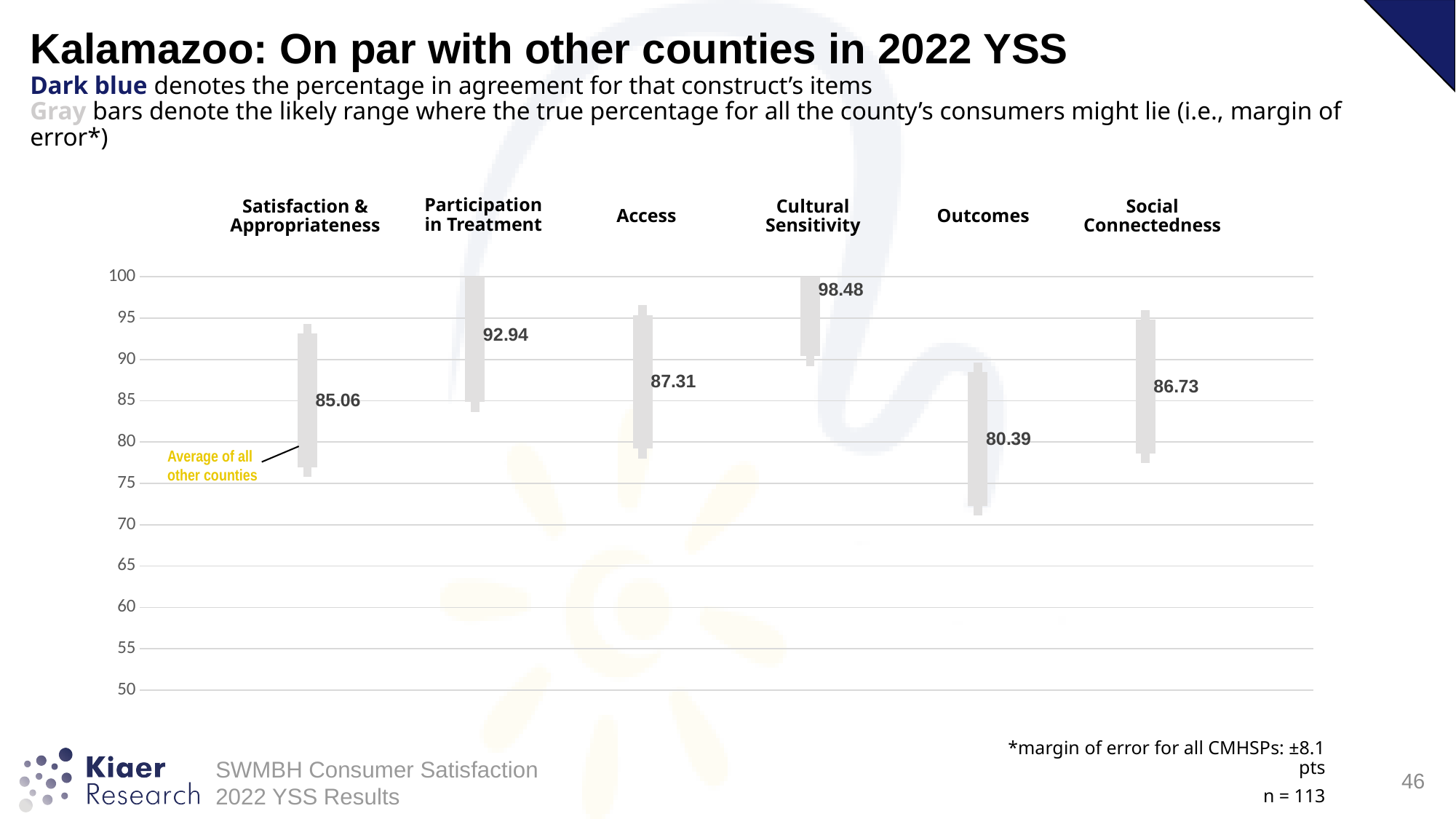
What is the value shown for Social Connectedness? 86.73 What is the difference between the values for Cultural Sensitivity and Outcomes? 18.09 What is the value shown for Cultural Sensitivity? 98.48 Which construct has the lowest value? Outcomes Is the value for Participation in Treatment greater or less than 90? greater How many constructs are shown on the chart? 6 Which construct has the highest value? Cultural Sensitivity What is the value shown for Outcomes? 80.39 What is the lowest value shown on the vertical axis? 50 According to the slide, what do the gray bars denote? The likely range where the true percentage might lie (margin of error) Which is larger, the value for Access or the value for Satisfaction & Appropriateness? Access What is the value shown for Participation in Treatment? 92.94